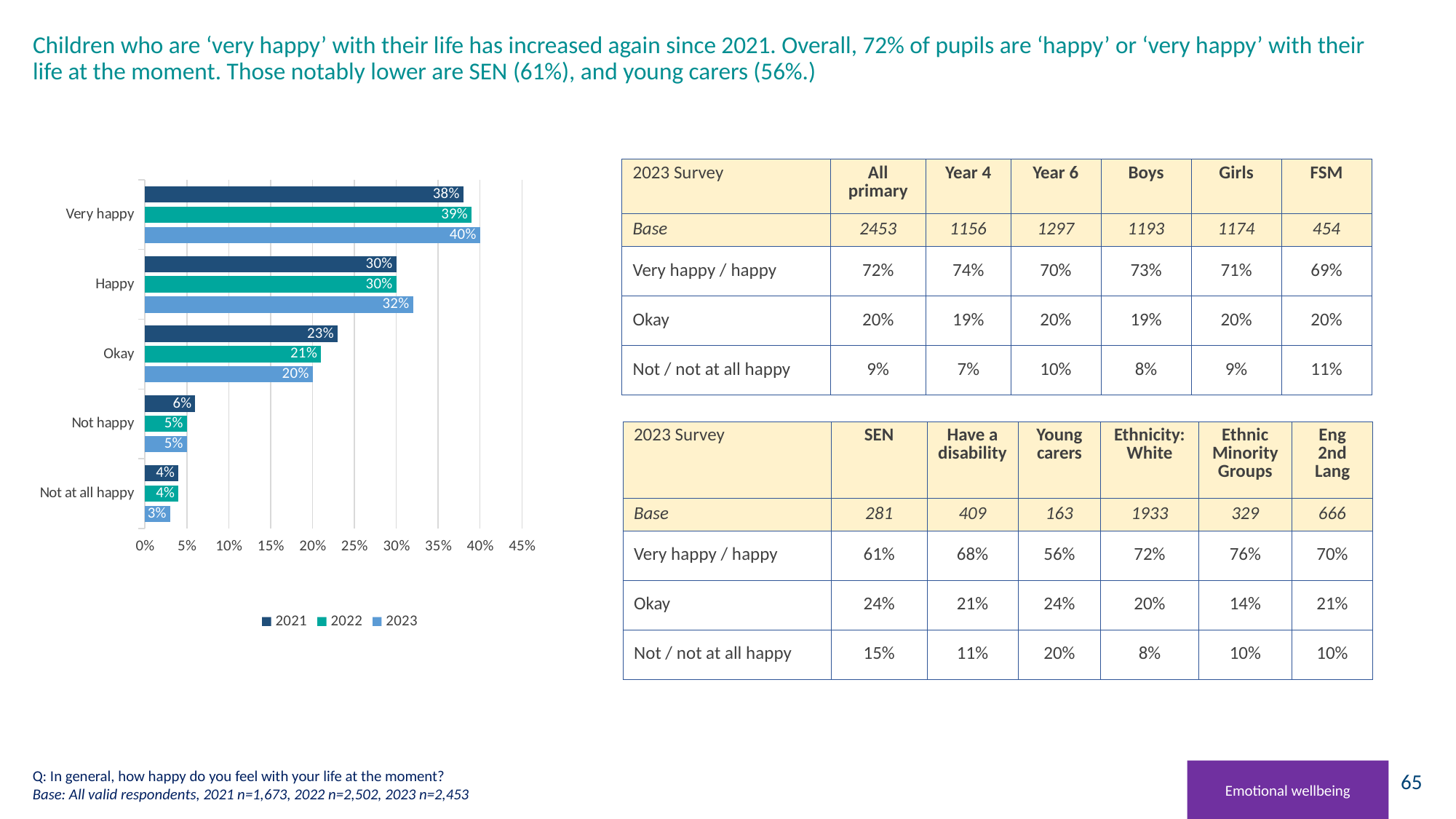
Which years are listed in the chart legend? 2021, 2022, 2023 What type of chart is shown on the slide? Bar chart Is the 2021 value for 'Happy' greater or less than 25%? greater Which category has the lowest value for the 2021 series? Not at all happy How many series does the chart legend list? 3 Which is larger: the 2023 value for 'Happy' or the 2022 value for 'Happy'? 2023 What is the difference between the 2023 and 2021 values for 'Very happy'? 2% Which category has the highest value for the 2022 series? Very happy What percentage of pupils were 'Not at all happy' in 2023? 3% What percentage of pupils were 'Okay' in 2021? 23% How many response categories are shown on the chart? 5 What percentage of pupils were 'Very happy' in 2023? 40%